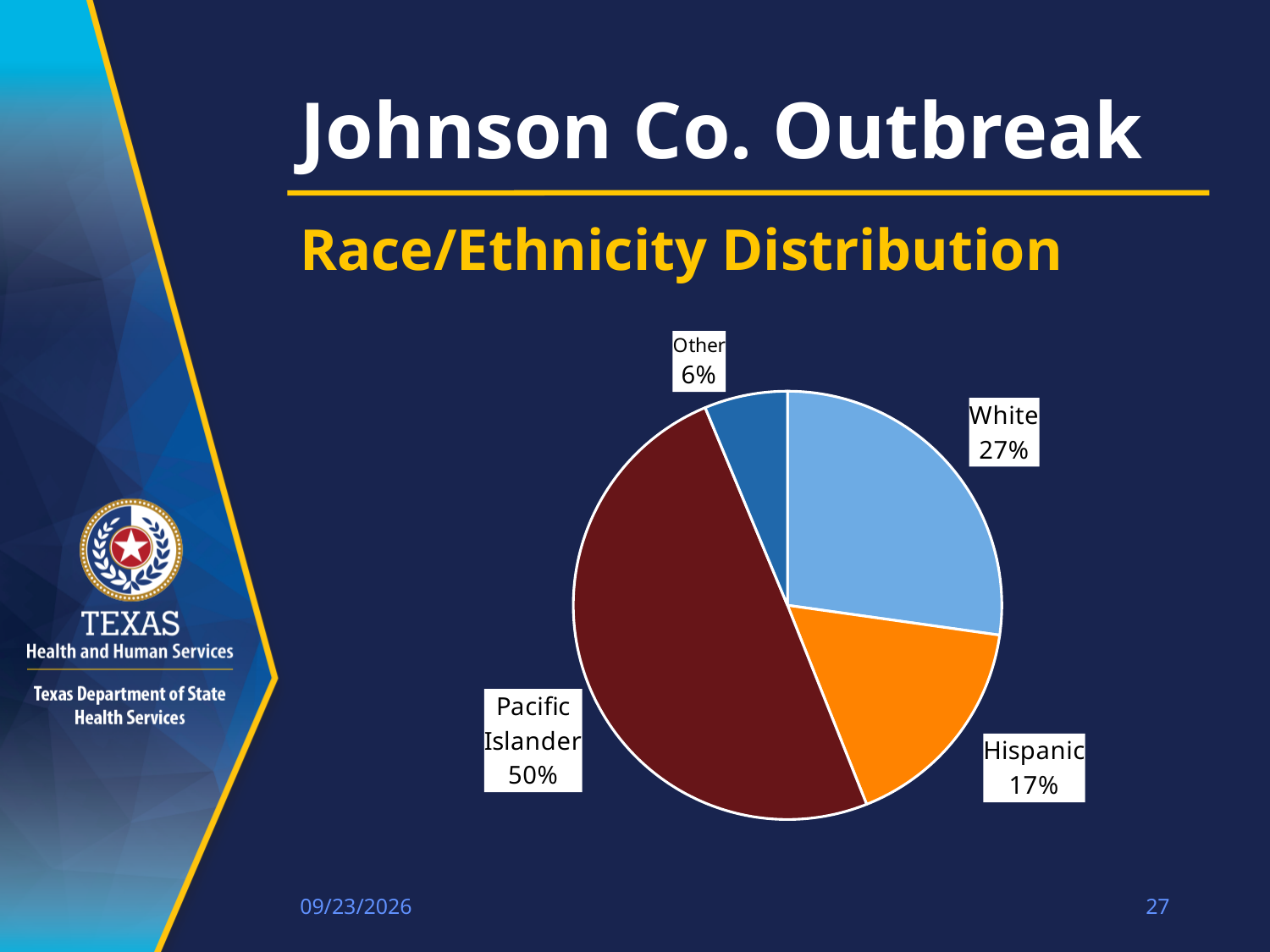
What is the difference in percentage points between the White and Hispanic slices? 10 What kind of chart is shown on the slide? pie chart Which category has the smallest share of the pie? Other What percentage of the pie is Hispanic? 17% How many slices does the pie chart have? 4 What percentage of the pie is Other? 6% What is the difference in percentage points between the Pacific Islander and Other slices? 44 What percentage of the pie is White? 27% What is the subtitle of the chart on the slide? Race/Ethnicity Distribution Which is larger, the White slice or the Hispanic slice? White What percentage of the pie is Pacific Islander? 50% Which category has the largest share of the pie? Pacific Islander